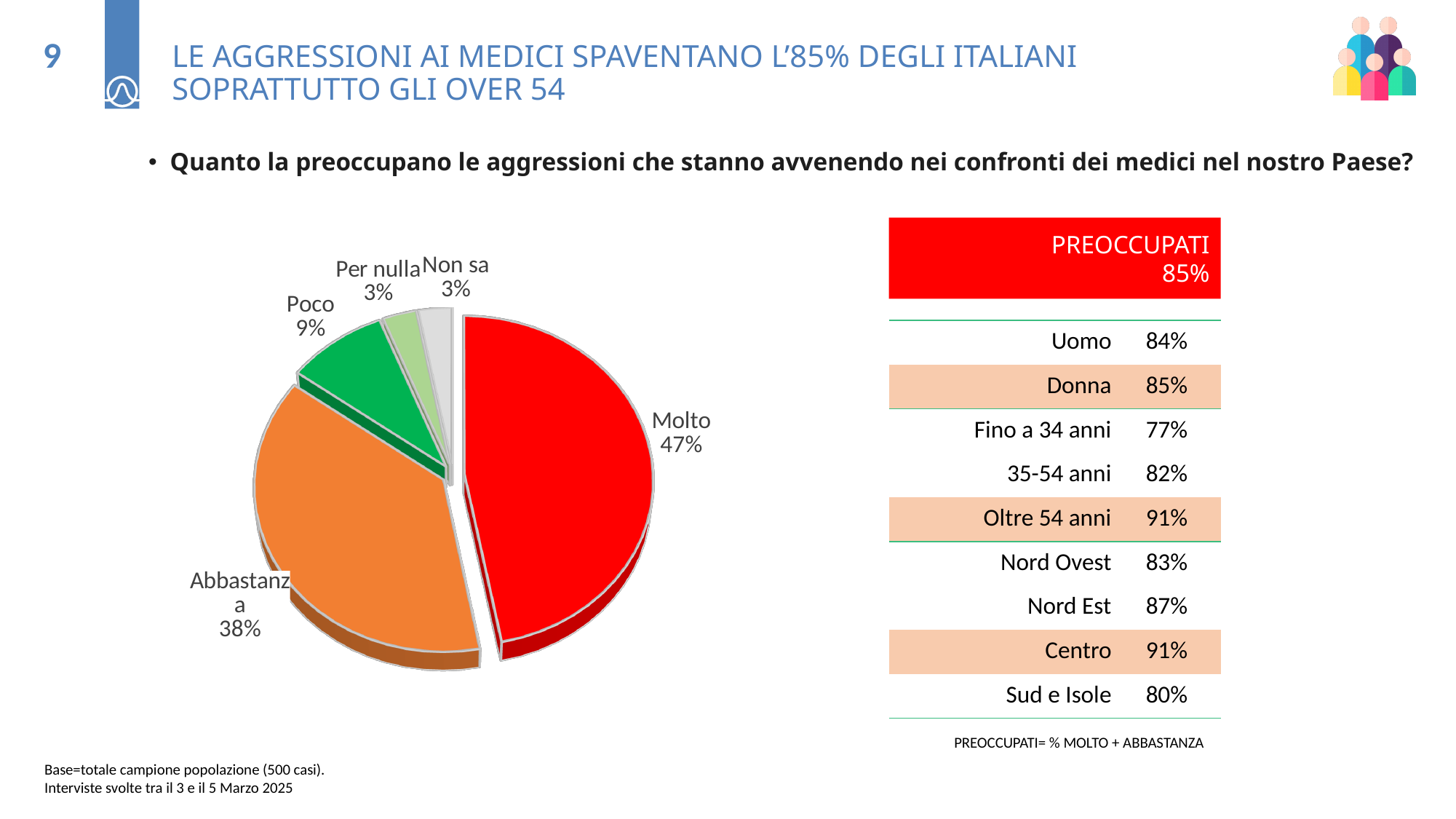
What is the value for 'Per nulla' in the pie chart? 3% What share of the pie does 'Molto' represent? 47% Which category has the largest slice in the pie chart? Molto What is the value for 'Abbastanza' in the pie chart? 38% Which is larger in the pie chart, 'Poco' or 'Non sa'? Poco What kind of chart is shown on the slide? pie chart What is the value for 'Poco' in the pie chart? 9% What is the difference between the 'Molto' and 'Abbastanza' slices? 9% What colour is the 'Abbastanza' slice in the pie chart? orange What is the combined total of the 'Molto' and 'Abbastanza' slices? 85% How many slices does the pie chart have? 5 What colour is the 'Molto' slice in the pie chart? red